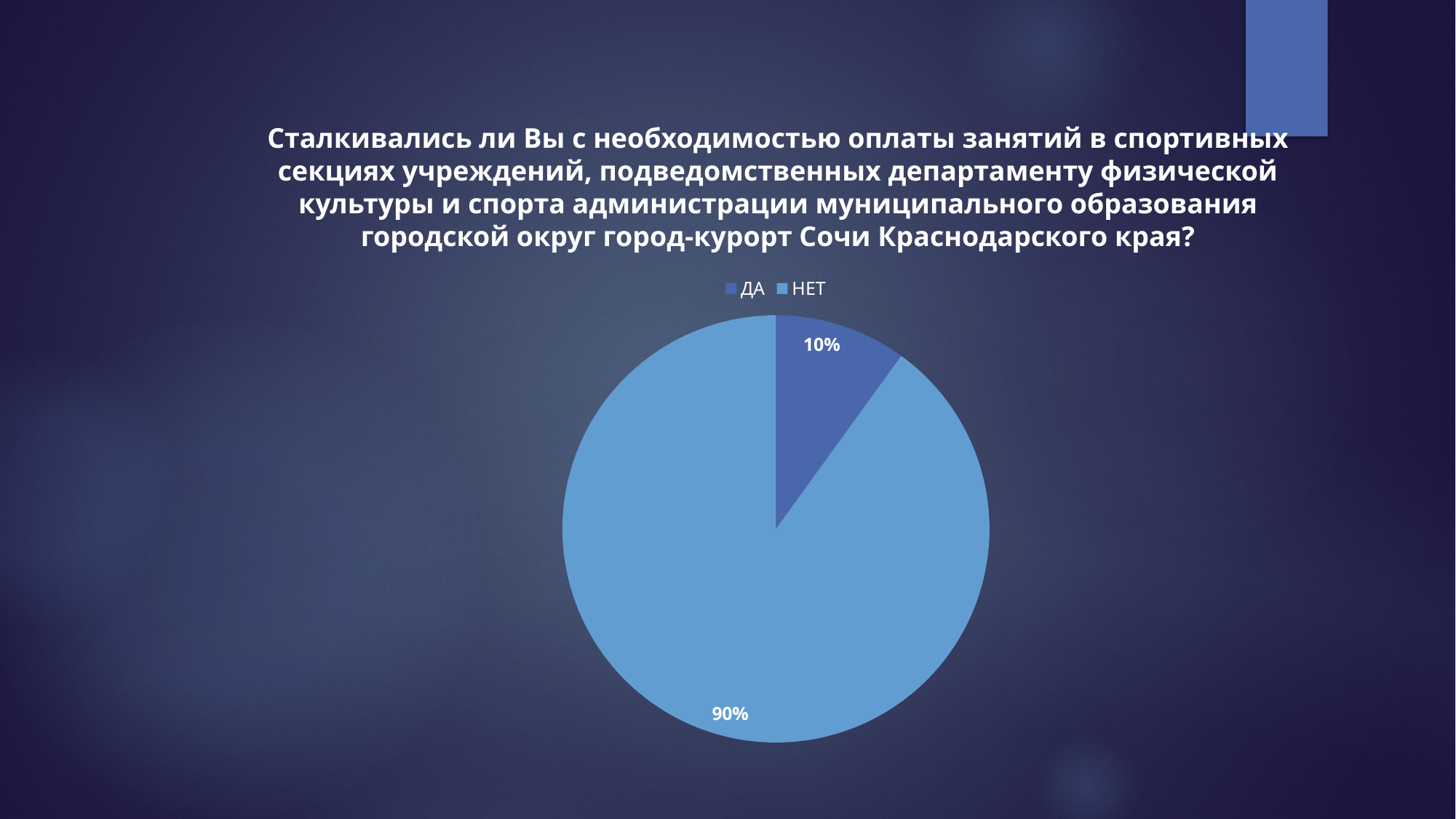
Which slice is larger, ДА or НЕТ? НЕТ How many slices does the pie chart have? 2 Which legend entry is shown in the darker blue colour? ДА What is the total of the two slices shown in the pie chart? 100% What percentage of respondents answered ДА? 10% Which answer has the smallest share of the pie? ДА How many entries does the legend list? 2 What is the difference in percentage points between the НЕТ and ДА slices? 80% What percentage of respondents answered НЕТ? 90% Which answer has the largest share of the pie? НЕТ What kind of chart is shown on the slide? Pie chart What share of the pie does the НЕТ slice represent? 90%